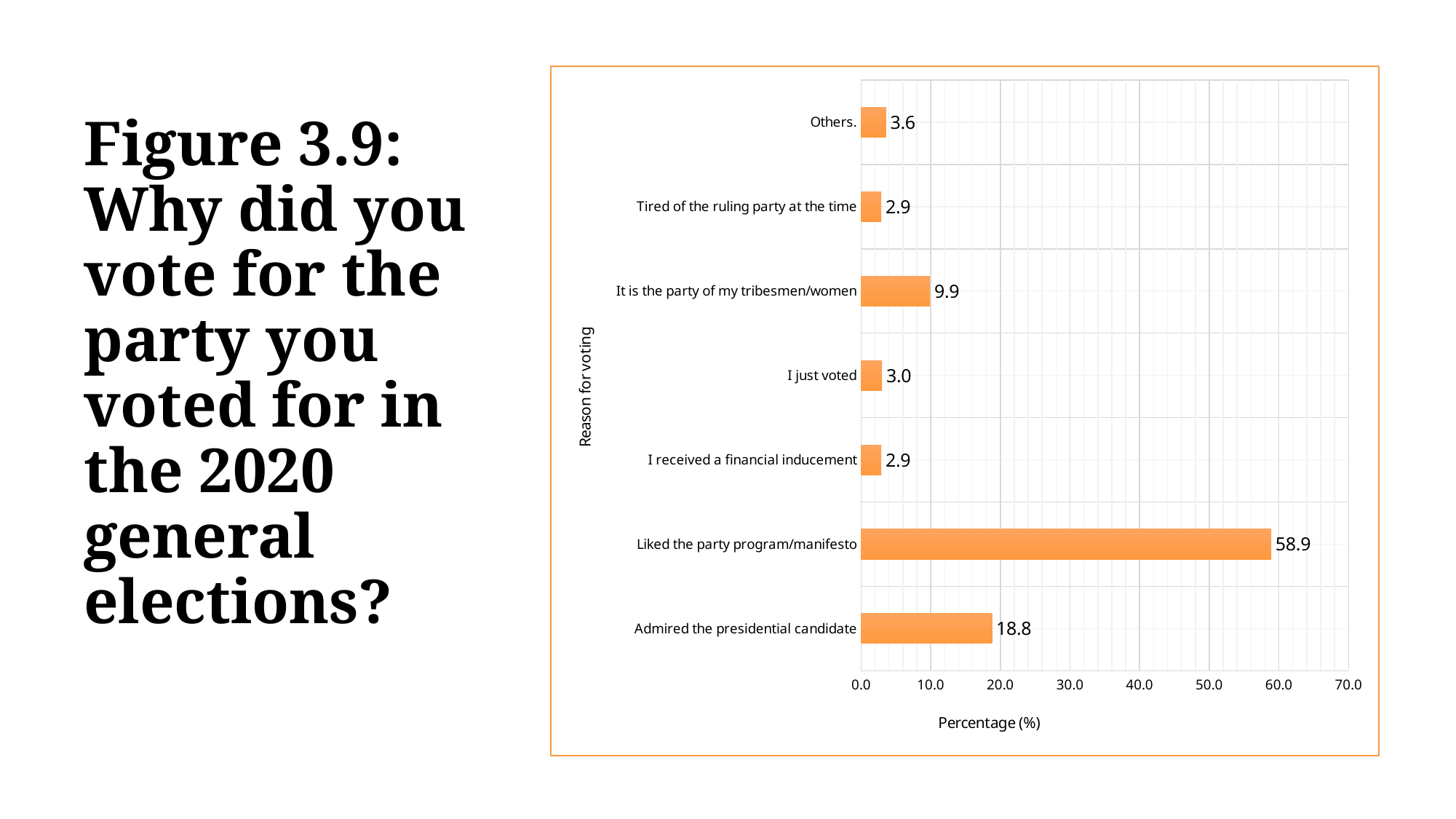
What is the difference between 'Liked the party program/manifesto' and 'Admired the presidential candidate'? 40.1 Is the value for 'Admired the presidential candidate' greater or less than 20.0? less What is the value for 'It is the party of my tribesmen/women'? 9.9 What is the label of the horizontal axis? Percentage (%) Which is larger: 'It is the party of my tribesmen/women' or 'I just voted'? It is the party of my tribesmen/women What percentage of respondents said they liked the party program/manifesto? 58.9 What is the value for 'Others.'? 3.6 What is the label of the vertical axis? Reason for voting How many reasons for voting are shown on the chart? 7 Which reason for voting has the highest percentage? Liked the party program/manifesto What is the value for 'Admired the presidential candidate'? 18.8 What kind of chart is shown on the slide? bar chart